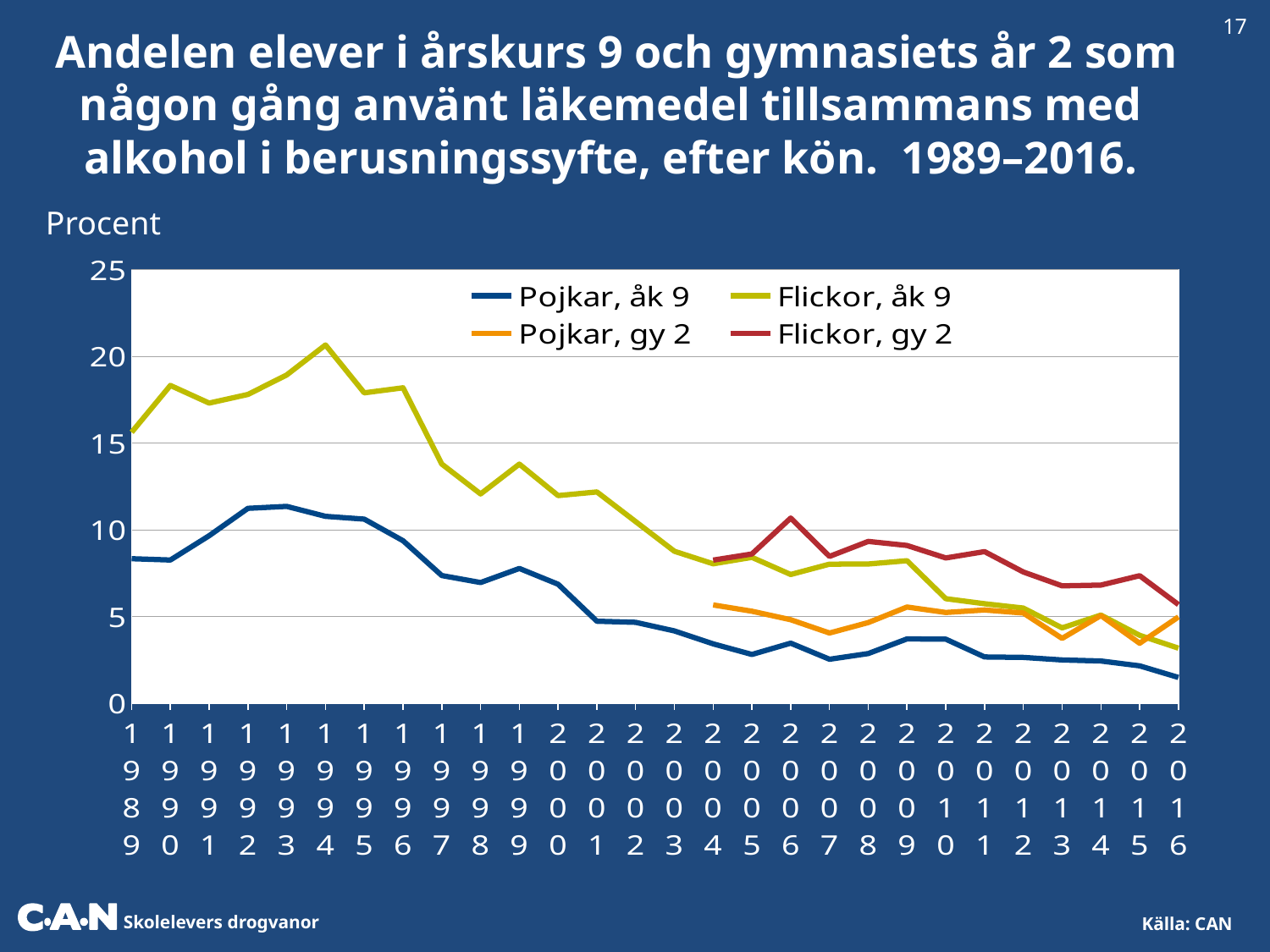
How many years are shown along the x axis? 28 What label is shown above the y axis? Procent Is the value for Flickor, åk 9 in 1994 greater or less than 20? greater What kind of chart is shown on the slide? line chart In 2006, which is larger: Flickor, gy 2 or Pojkar, gy 2? Flickor, gy 2 How many series does the legend list? 4 Is the value for Pojkar, åk 9 in 2016 greater or less than 5? less Which series has the lowest value in 2016? Pojkar, åk 9 Which series has the highest value in 1994? Flickor, åk 9 Is the value for Flickor, åk 9 in 1990 greater or less than 15? greater Does the Flickor, åk 9 series rise or fall from 1994 to 2016? fall